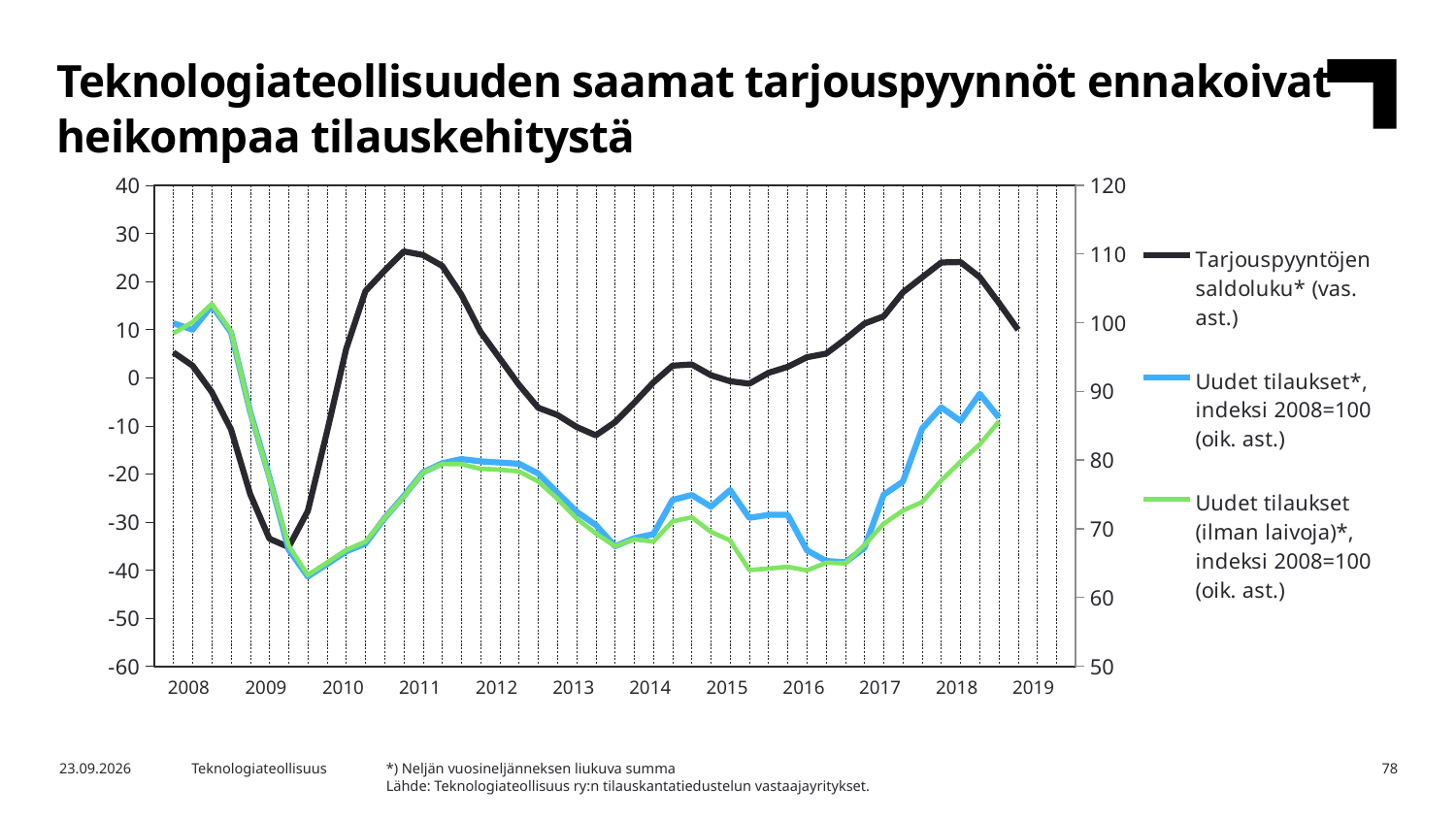
Is the peak value of Tarjouspyyntöjen saldoluku around 2011 greater or less than 20? greater Is the lowest value of Tarjouspyyntöjen saldoluku (around 2009) greater or less than -30? less What is the title of the slide? Teknologiateollisuuden saamat tarjouspyynnöt ennakoivat heikompaa tilauskehitystä What kind of chart is shown on the slide? Line chart How many series does the legend list? 3 How many year labels are shown on the x axis? 12 Which series is plotted on the left axis (vas. ast.)? Tarjouspyyntöjen saldoluku* Is the lowest value of Uudet tilaukset (ilman laivoja) around 2009 greater or less than 70 on the right axis? less In 2016, which series is higher: Uudet tilaukset or Uudet tilaukset (ilman laivoja)? Uudet tilaukset Does Tarjouspyyntöjen saldoluku rise or fall from 2018 to 2019? fall